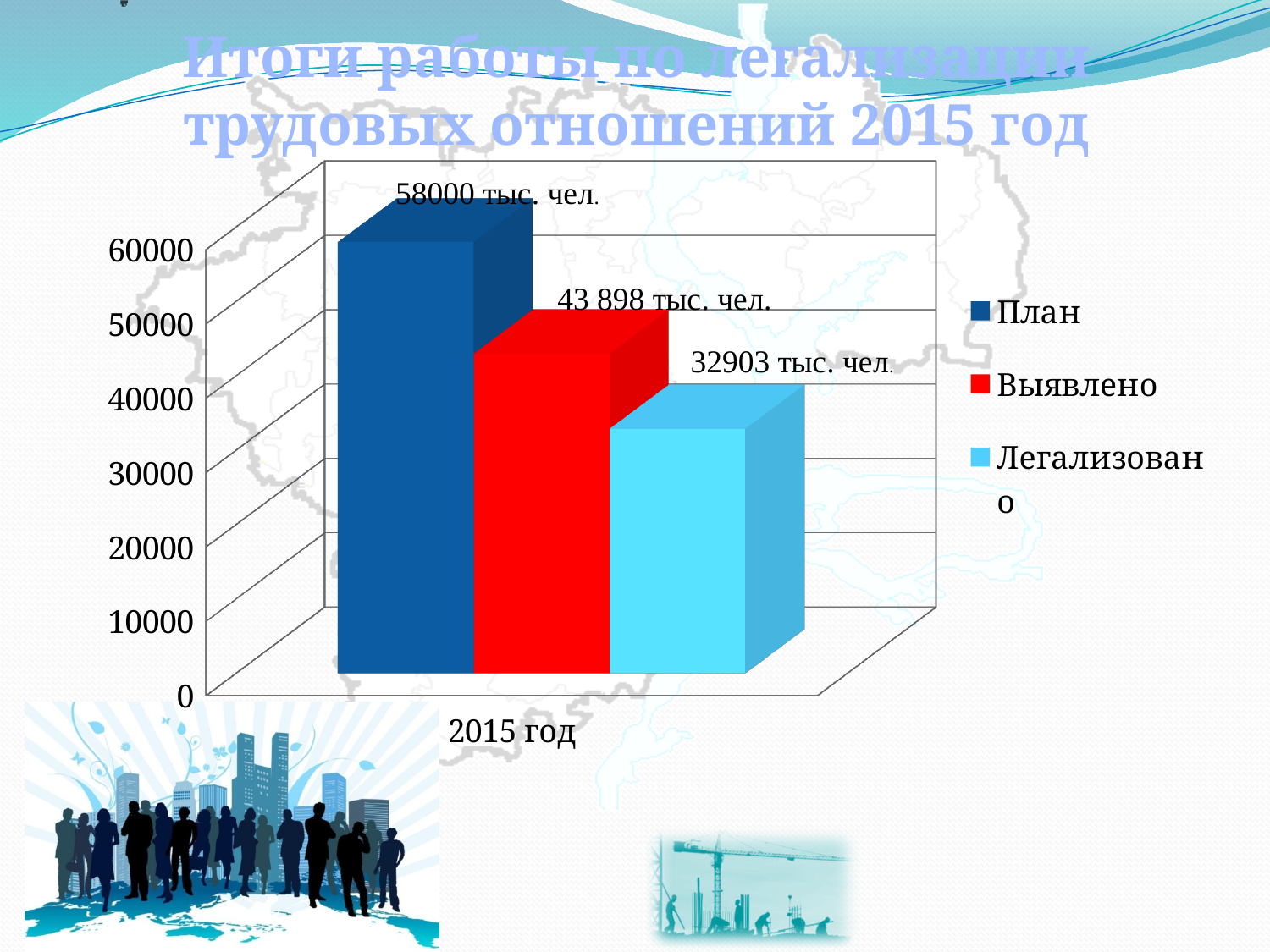
What is the difference between the План value and the Выявлено value? 14102 тыс. чел. What is the difference between the Выявлено value and the Легализовано value? 10995 тыс. чел. What is the value for Легализовано (legalized) in 2015? 32903 тыс. чел. Which series has the highest value on the chart? План Is the value for Легализовано greater or less than 40000? less What kind of chart is shown on the slide? bar chart What is the value for Выявлено (identified) in 2015? 43 898 тыс. чел. What colour is the bar for Выявлено? red Which series has the lowest value on the chart? Легализовано Which is larger, the value for Выявлено or the value for Легализовано? Выявлено How many series does the legend list? 3 What is the value for План (plan) in 2015? 58000 тыс. чел.